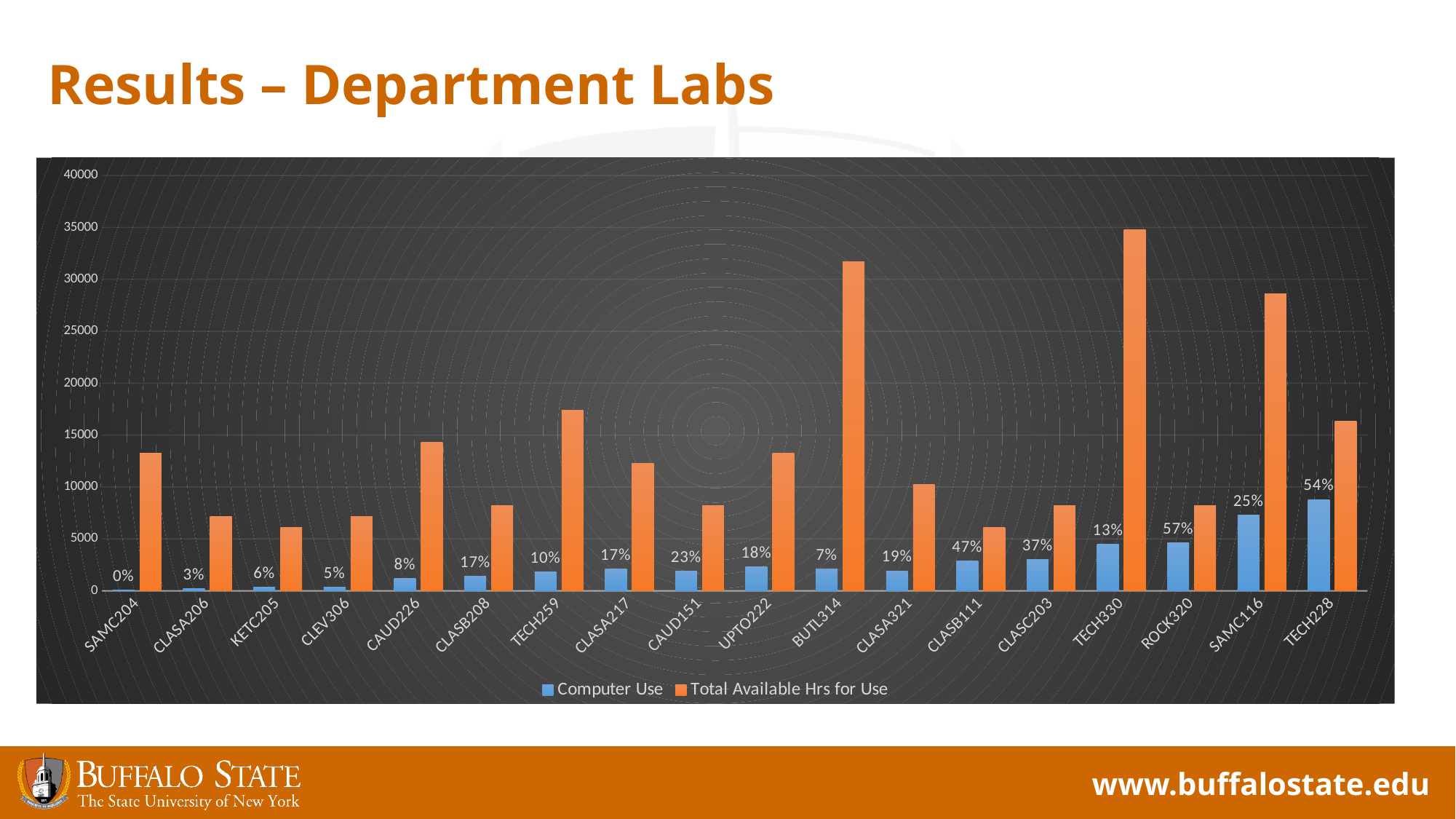
Which has the larger Total Available Hrs for Use bar, BUTL314 or SAMC116? BUTL314 Which lab has the highest Total Available Hrs for Use bar? TECH330 How many lab categories are shown along the x axis? 18 Is the Total Available Hrs for Use value for TECH330 greater or less than 30000? greater Which series is shown in orange in the legend? Total Available Hrs for Use What kind of chart is shown on the slide? bar chart How many series does the chart legend list? 2 What percentage label is shown above the Computer Use bar for CLASB111? 47% What percentage label is shown above the Computer Use bar for SAMC204? 0% What percentage label is shown above the Computer Use bar for ROCK320? 57% Which lab has the highest percentage label above its Computer Use bar? ROCK320 Is the Total Available Hrs for Use value for CLASA206 greater or less than 10000? less